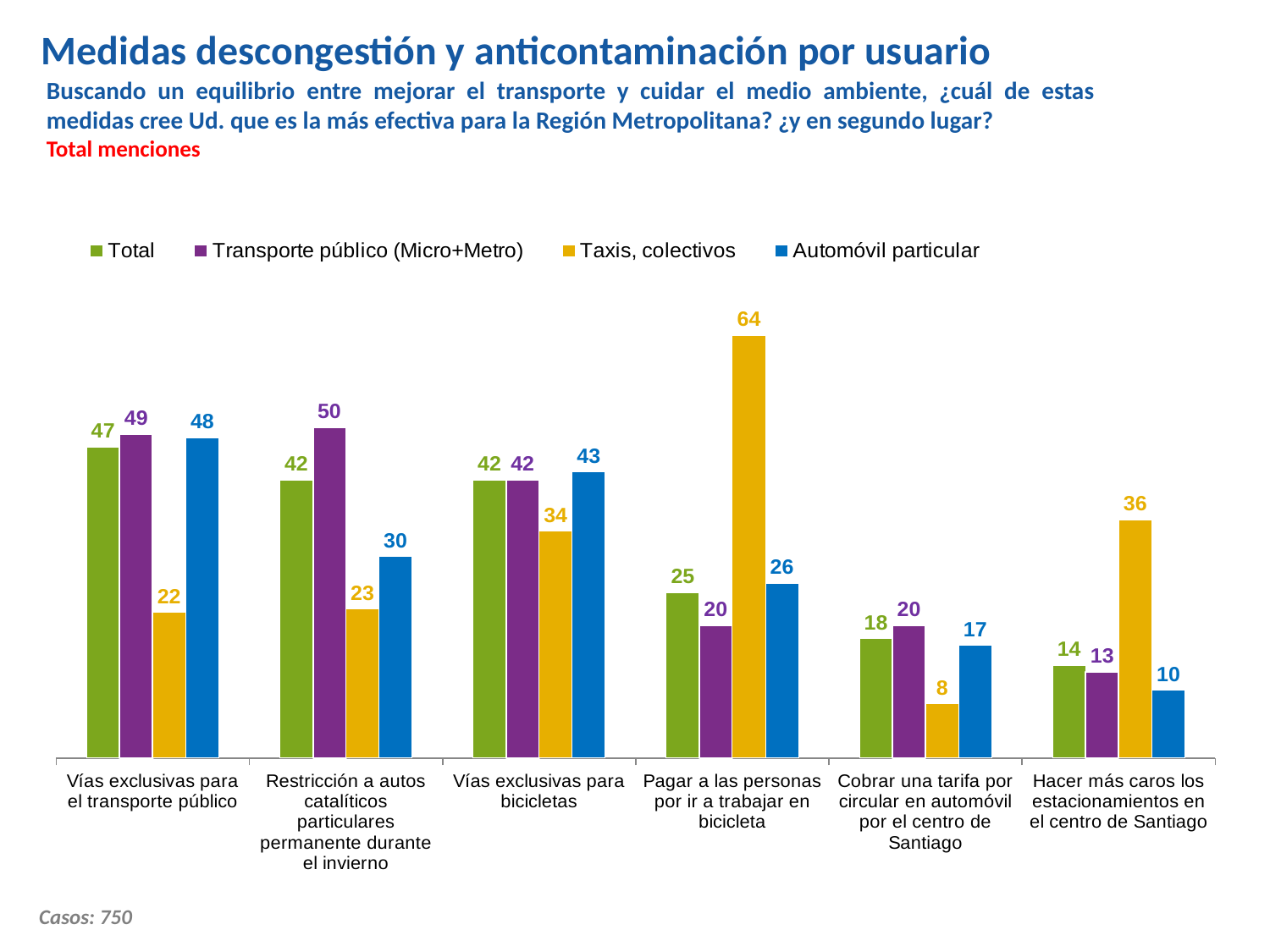
What is the "Total" value for "Vías exclusivas para el transporte público"? 47 What is the value for "Taxis, colectivos" in the category "Pagar a las personas por ir a trabajar en bicicleta"? 64 What colour represents the "Automóvil particular" series? Blue How many series does the legend list? 4 What kind of chart is shown on the slide? Bar chart Which category has the highest "Total" value? Vías exclusivas para el transporte público Does the "Total" series rise or fall from the first category to the last category along the x axis? Fall How many categories are shown on the x axis? 6 What is the value for "Automóvil particular" in the category "Restricción a autos catalíticos particulares permanente durante el invierno"? 30 What is the difference between the "Taxis, colectivos" value and the "Transporte público (Micro+Metro)" value for "Pagar a las personas por ir a trabajar en bicicleta"? 44 Which category has the lowest value for "Taxis, colectivos"? Cobrar una tarifa por circular en automóvil por el centro de Santiago For "Hacer más caros los estacionamientos en el centro de Santiago", which is larger: the "Taxis, colectivos" value or the "Automóvil particular" value? Taxis, colectivos